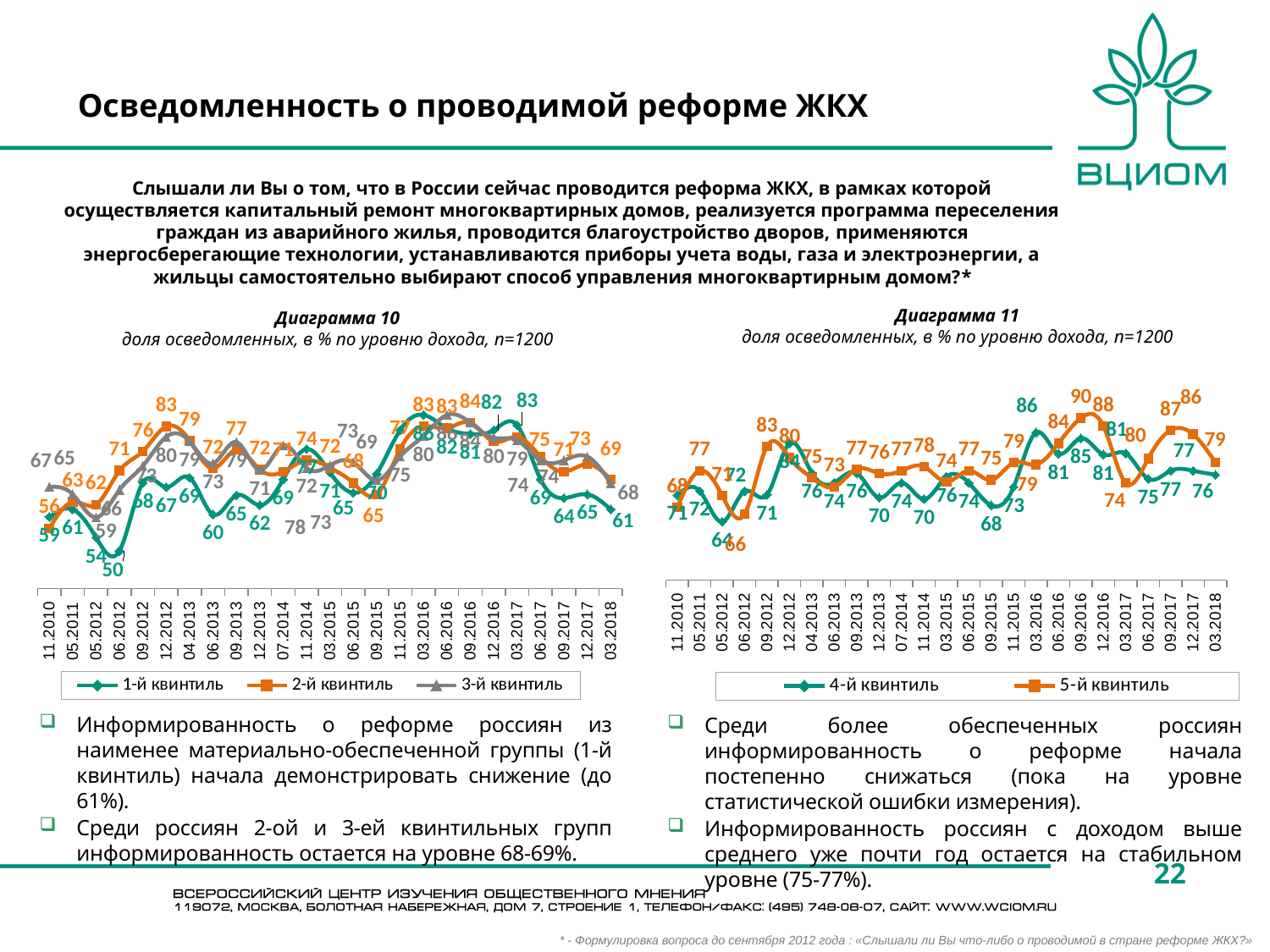
In Диаграмма 11, what is the value for 4-й квинтиль at 03.2018? 76 How many series does the legend of Диаграмма 11 list? 2 What kind of chart is Диаграмма 10? line chart In Диаграмма 10, what is the value for 2-й квинтиль at 03.2018? 69 In Диаграмма 11, what is the highest value reached by 5-й квинтиль? 90 In Диаграмма 11, what is the difference between 5-й квинтиль and 4-й квинтиль at 03.2018? 3 In Диаграмма 11, what is the value for 5-й квинтиль at 03.2018? 79 How many series does the legend of Диаграмма 10 list? 3 In Диаграмма 10, which is larger at 03.2018: 2-й квинтиль or 1-й квинтиль? 2-й квинтиль Which series are listed in the legend of Диаграмма 11? 4-й квинтиль and 5-й квинтиль In Диаграмма 10, what is the lowest value reached by 1-й квинтиль? 50 In Диаграмма 10, what is the value for 1-й квинтиль at 03.2018? 61